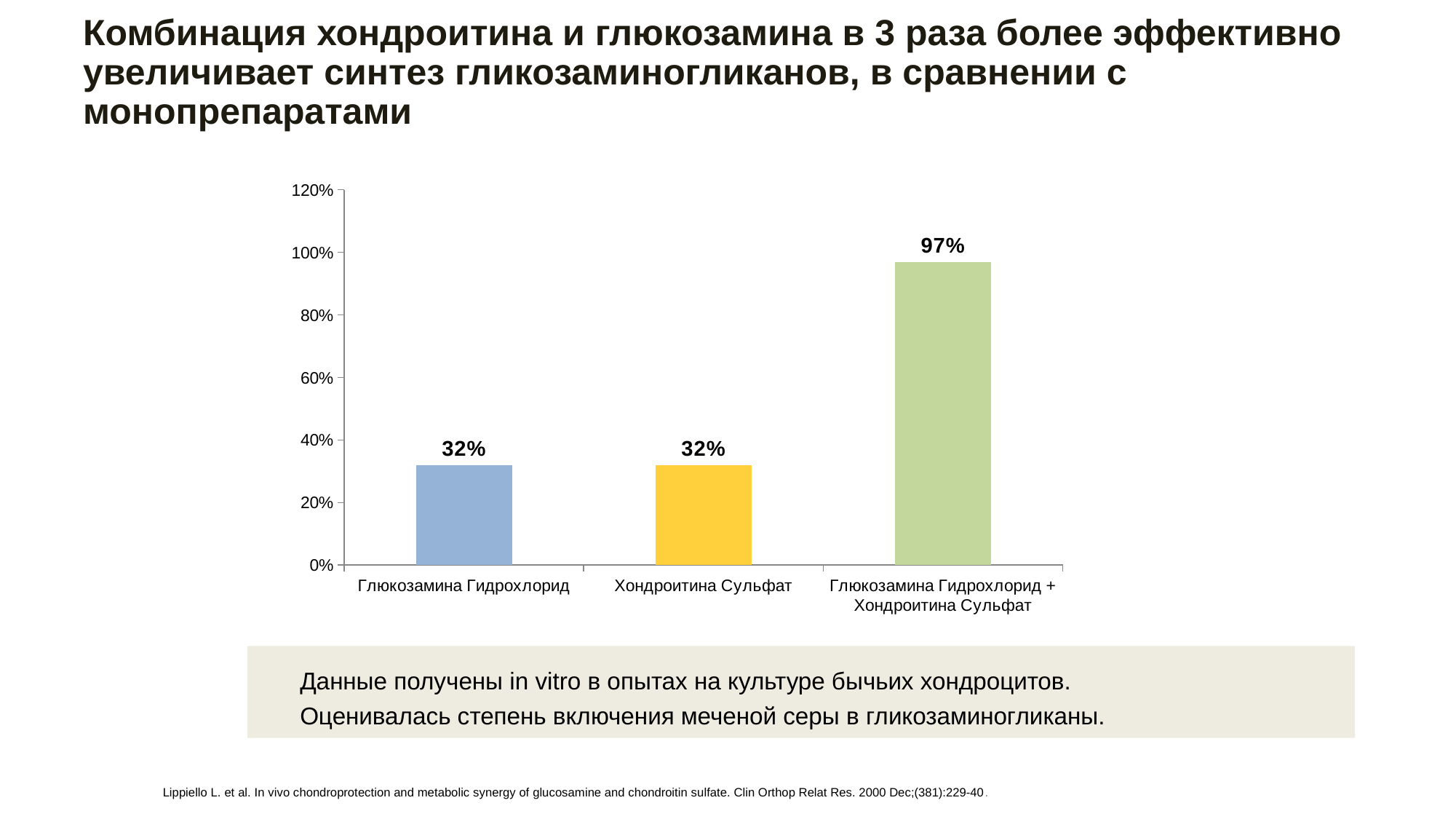
What is the highest value shown on the y axis? 120% Is the value for Глюкозамина Гидрохлорид + Хондроитина Сульфат greater or less than 80%? greater What kind of chart is shown on the slide? Bar chart What is the value for Глюкозамина Гидрохлорид? 32% Is the value for Хондроитина Сульфат greater or less than 40%? less What is the value for Глюкозамина Гидрохлорид + Хондроитина Сульфат? 97% What is the difference between the value for Глюкозамина Гидрохлорид + Хондроитина Сульфат and the value for Хондроитина Сульфат? 65% Which is larger: the value for Глюкозамина Гидрохлорид + Хондроитина Сульфат or the value for Глюкозамина Гидрохлорид? Глюкозамина Гидрохлорид + Хондроитина Сульфат What colour is the bar for Хондроитина Сульфат? Yellow How many categories are shown on the chart? 3 What is the value for Хондроитина Сульфат? 32% Which category has the highest value? Глюкозамина Гидрохлорид + Хондроитина Сульфат